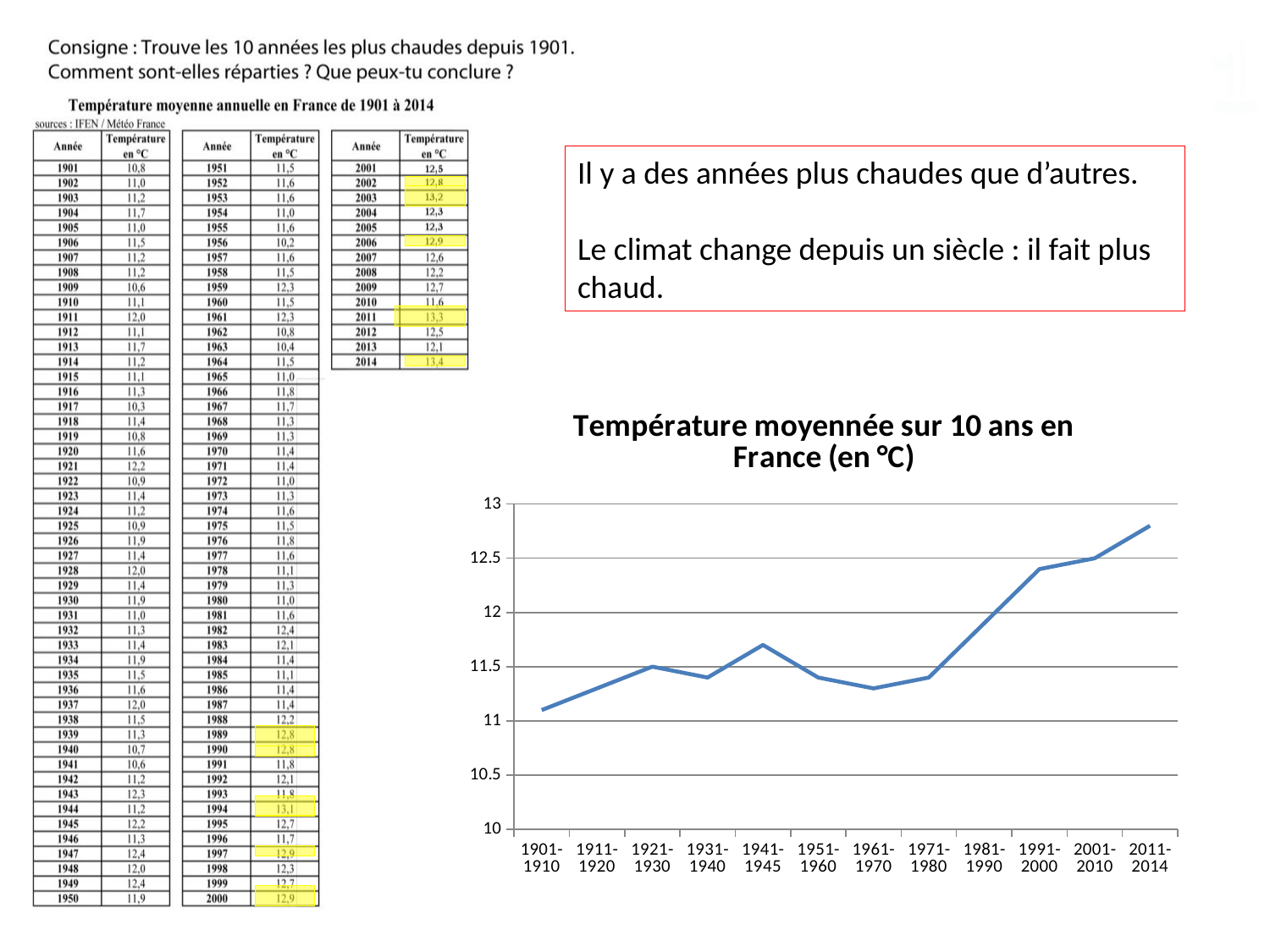
Which period has the highest value in the chart? 2011-2014 What kind of chart is shown on the slide? line chart Is the value for 1961-1970 greater or less than 11.5? less Which period has the lowest value in the chart? 1901-1910 What is the title of the chart on the slide? Température moyennée sur 10 ans en France (en °C) Which is larger, the value for 1941-1945 or the value for 1961-1970? 1941-1945 Overall, do the values rise or fall from 1901-1910 to 2011-2014? rise Is the value for 1941-1945 greater or less than 11.5? greater Is the value for 1991-2000 greater or less than 12? greater How many periods are plotted along the x axis of the chart? 12